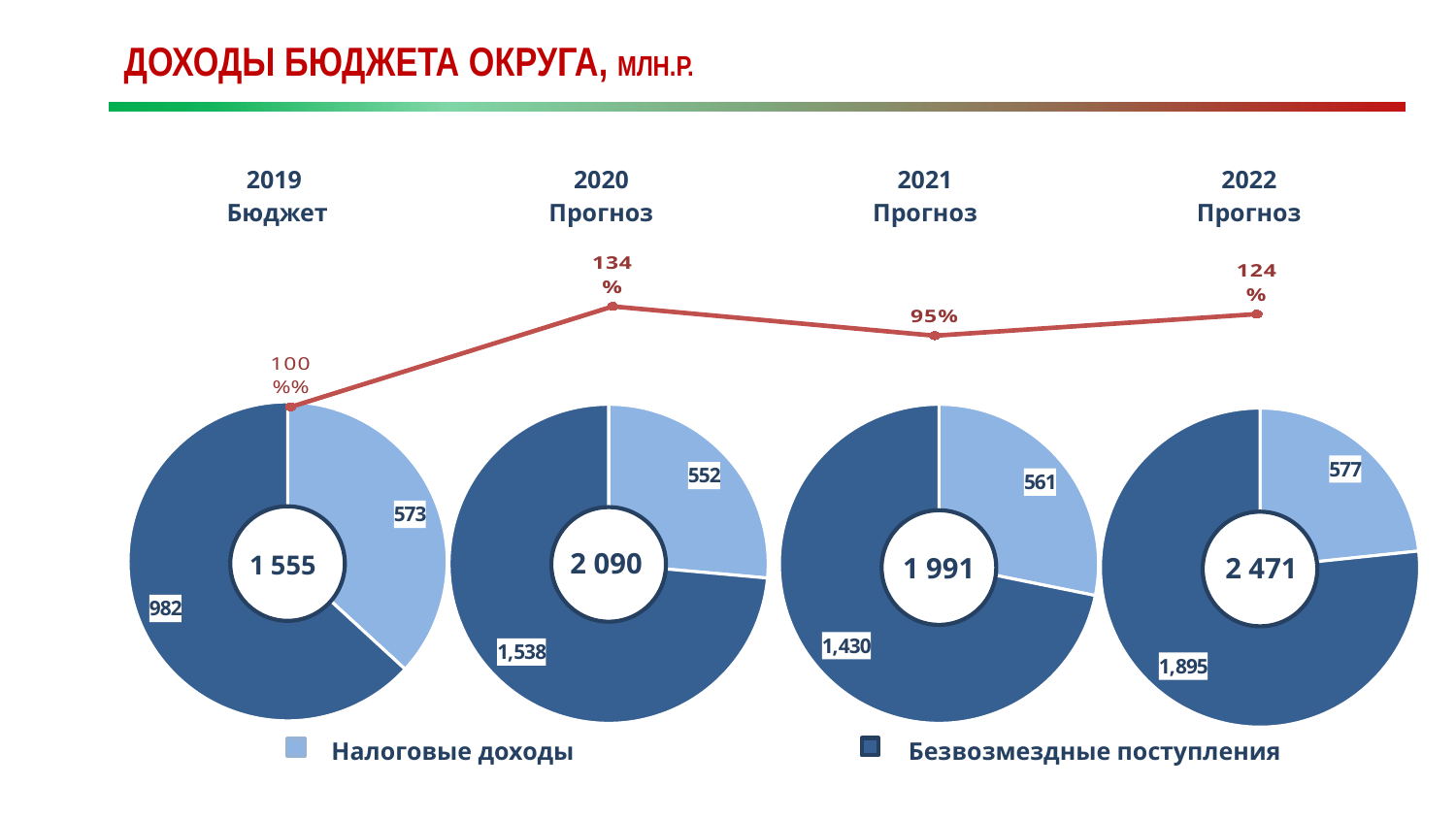
On the red line above the donut charts, what percentage is shown for 2020 Прогноз? 134% How many series does the legend list? 2 Which is larger: Налоговые доходы in the 2021 Прогноз chart or in the 2022 Прогноз chart? 2022 Прогноз In the 2019 Бюджет donut chart, how much larger is Безвозмездные поступления than Налоговые доходы? 409 What total is shown in the centre of the 2020 Прогноз donut chart? 2 090 In the 2022 Прогноз donut chart, what is the value for Безвозмездные поступления? 1,895 Which of the four donut charts shows the highest total in its centre? 2022 Прогноз How many donut charts are shown on the slide? 4 What is the difference between Безвозмездные поступления in the 2022 Прогноз chart and in the 2021 Прогноз chart? 465 In the 2019 Бюджет donut chart, what is the value for Налоговые доходы? 573 What kind of charts are used to show the budget revenues for each year? Pie (donut) charts Which of the four donut charts shows the lowest total in its centre? 2019 Бюджет